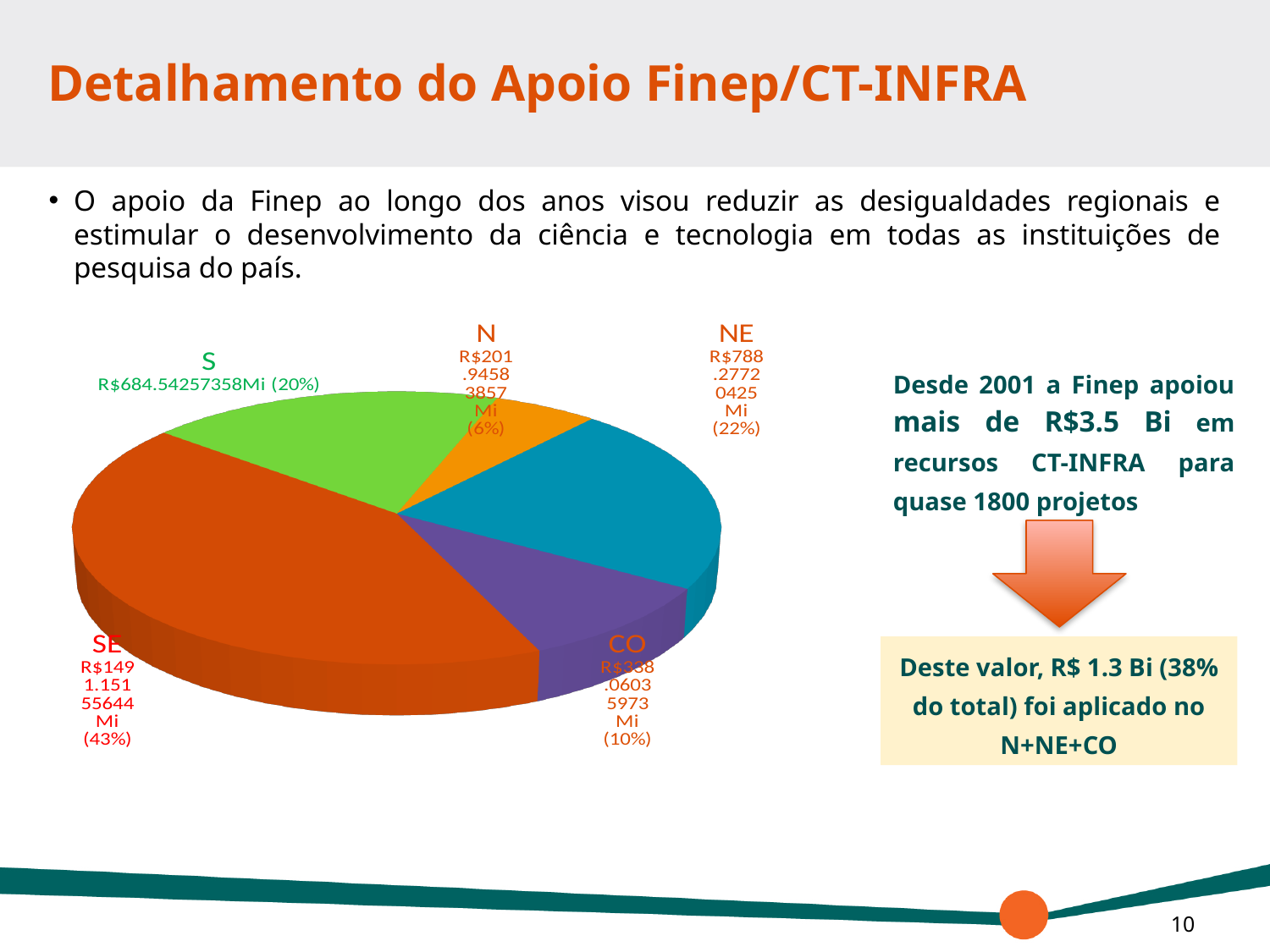
How many slices does the pie chart have? 5 By how many percentage points does the SE share exceed the S share? 23 What share of the pie does the NE region account for? 22% Which region has a larger share, NE or S? NE Which region has the largest slice of the pie? SE What share of the pie does the S region account for? 20% What share of the pie does the N region account for? 6% Which region has the smallest slice of the pie? N What value is shown for the S region? R$684.54257358Mi What kind of chart is shown on the slide? pie chart